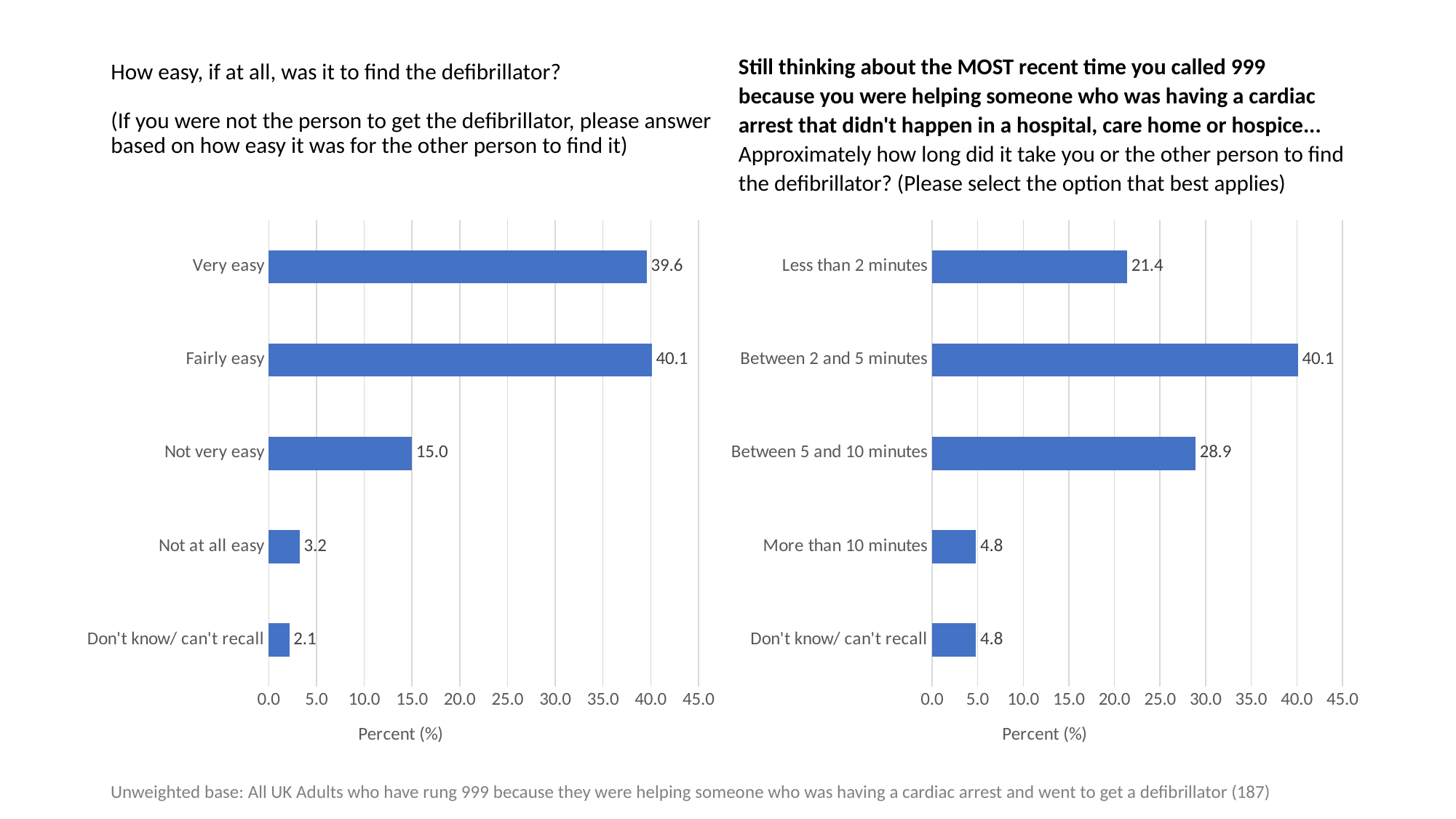
In the left chart (How easy was it to find the defibrillator), how many categories are shown? 5 In the left chart (How easy was it to find the defibrillator), which category has the lowest value? Don't know/ can't recall What kind of chart is the left chart (How easy was it to find the defibrillator)? Bar chart In the left chart (How easy was it to find the defibrillator), is the value for Not at all easy greater or less than 5.0? less In the left chart (How easy was it to find the defibrillator), what is the value for Very easy? 39.6 In the right chart (how long did it take to find the defibrillator), what is the value for Between 5 and 10 minutes? 28.9 In the right chart (how long did it take to find the defibrillator), what is the difference between Between 2 and 5 minutes and Less than 2 minutes? 18.7 In the right chart (how long did it take to find the defibrillator), what is the value for More than 10 minutes? 4.8 In the left chart (How easy was it to find the defibrillator), what is the difference between Fairly easy and Not very easy? 25.1 What is the x-axis label of the right chart (how long did it take to find the defibrillator)? Percent (%) In the right chart (how long did it take to find the defibrillator), which is larger: Less than 2 minutes or Between 5 and 10 minutes? Between 5 and 10 minutes In the right chart (how long did it take to find the defibrillator), which category has the highest value? Between 2 and 5 minutes